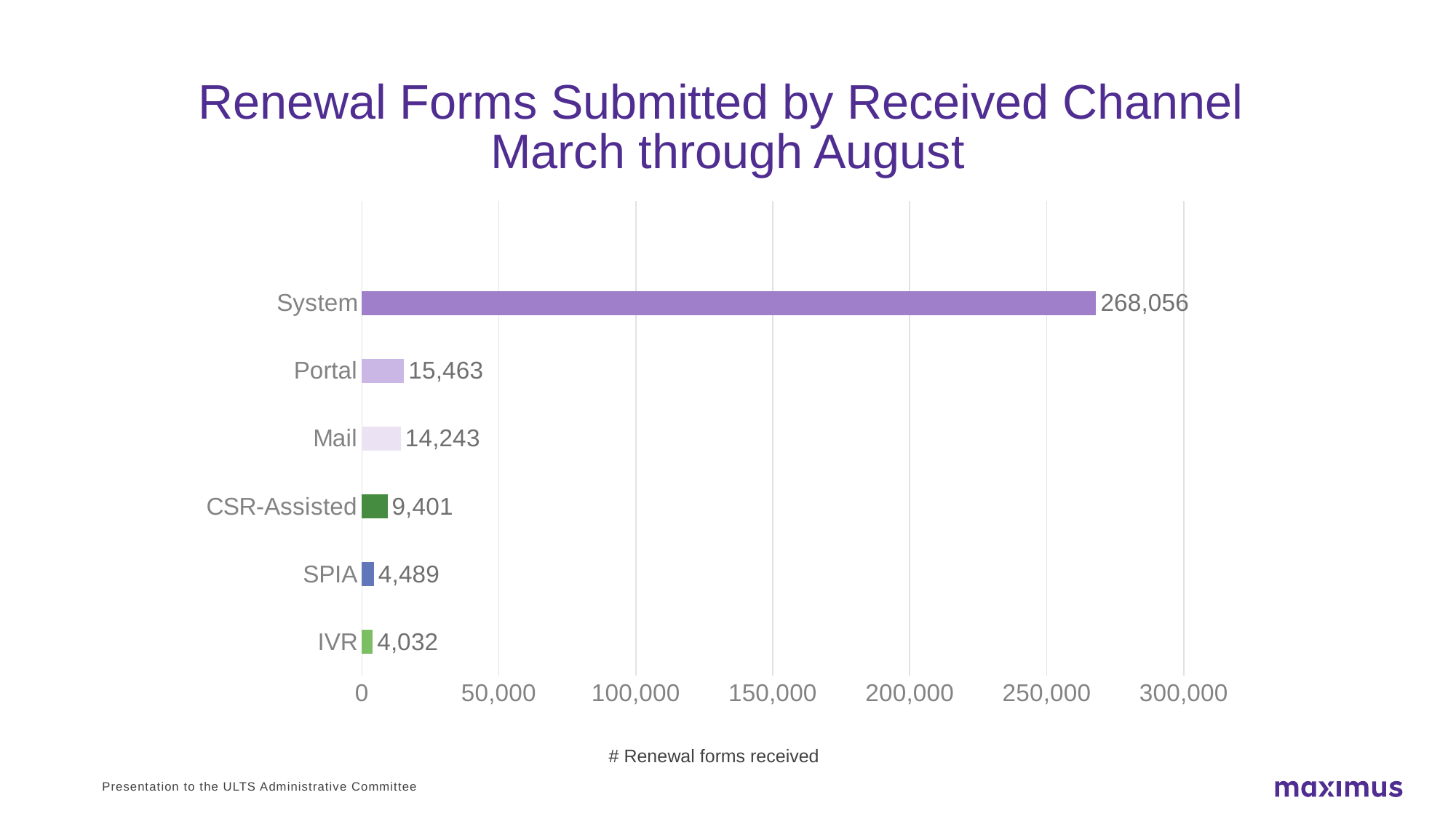
What is the difference between the Portal and Mail values? 1,220 What is the value for CSR-Assisted? 9,401 How many channels are shown in the chart? 6 Which is larger, the value for SPIA or the value for IVR? SPIA How many renewal forms were received by Mail? 14,243 Which channel received the fewest renewal forms? IVR Is the value for System greater or less than 250,000? greater How many renewal forms were received through the System channel? 268,056 What kind of chart is shown on the slide? bar chart Which channel received the most renewal forms? System What is the value for the Portal channel? 15,463 What is the label on the horizontal axis of the chart? # Renewal forms received